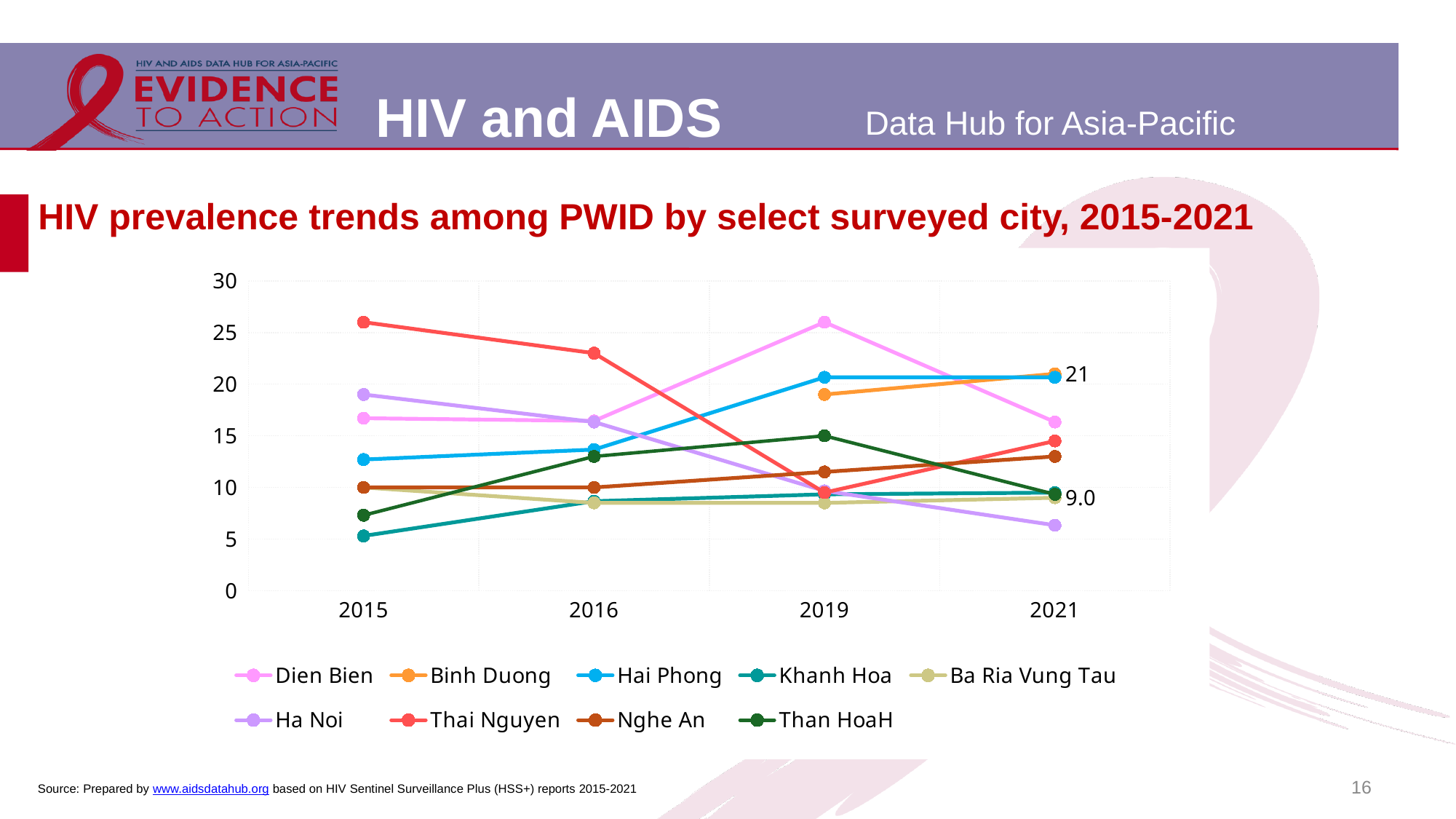
Is the value for Thai Nguyen in 2016 greater or less than 20? greater Which city has the highest HIV prevalence in 2015? Thai Nguyen Which city has the highest HIV prevalence in 2019? Dien Bien How many series does the legend list? 9 In 2016, which is higher: Thai Nguyen or Dien Bien? Thai Nguyen Which city has the lowest HIV prevalence in 2015? Khanh Hoa Is the value for Thai Nguyen in 2015 greater or less than 25? greater Is the value for Ha Noi in 2021 greater or less than 10? less How many years are shown on the x axis? 4 Which city has the lowest HIV prevalence in 2021? Ha Noi Does the Ha Noi line rise or fall from 2015 to 2021? fall What kind of chart is shown on the slide? line chart